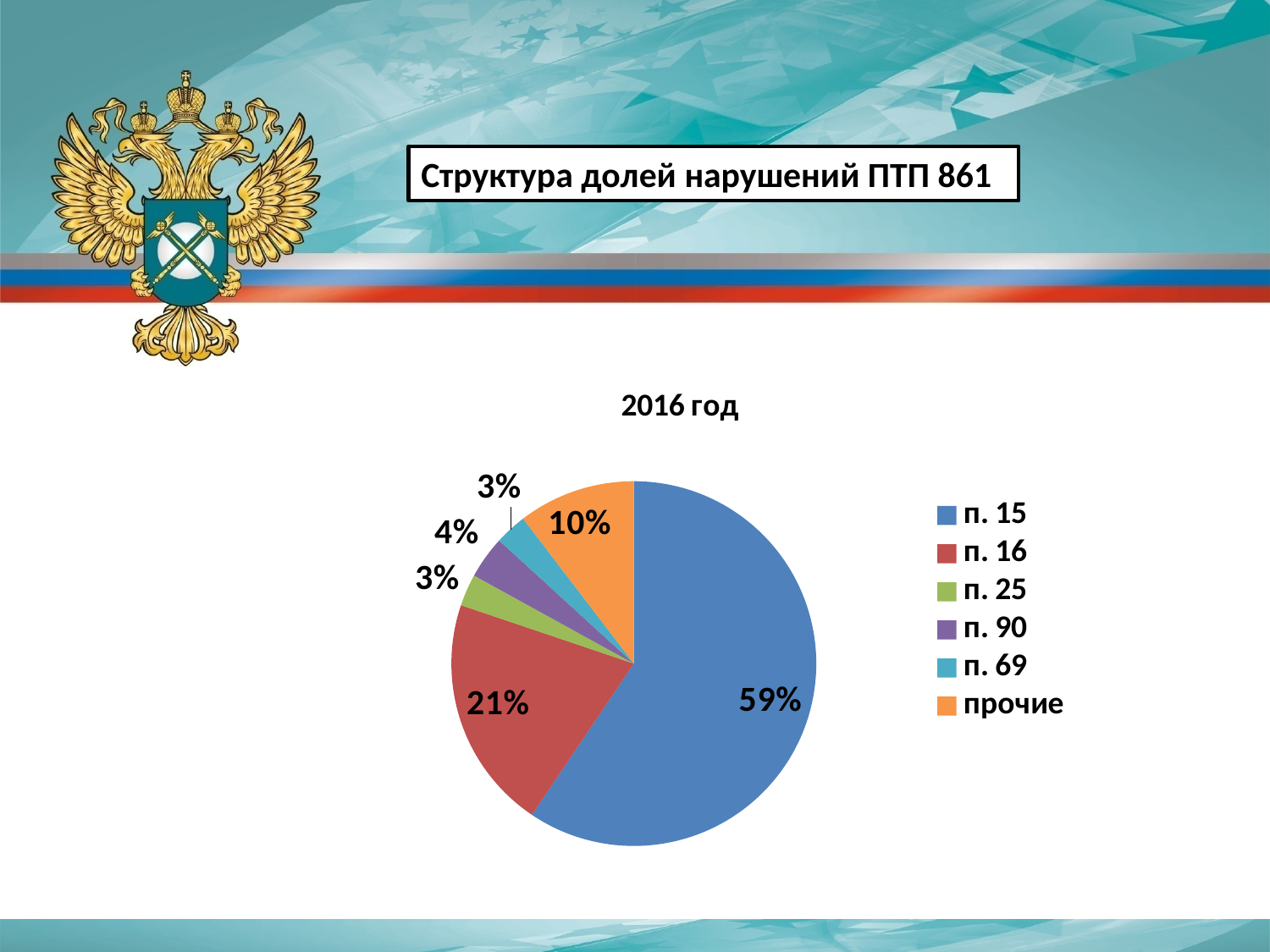
Which colour represents прочие in the legend? orange What share of the pie does п. 90 have? 4% What share of the pie does п. 15 have? 59% Which is larger, the share of п. 16 or the share of прочие? п. 16 Which category has the largest share of the pie? п. 15 What is the difference between the shares of п. 15 and п. 16? 38% What share of the pie does прочие have? 10% How many categories does the legend list? 6 What is the chart's title? 2016 год What type of chart is shown on the slide? pie chart What is the combined share of п. 15 and п. 16? 80%